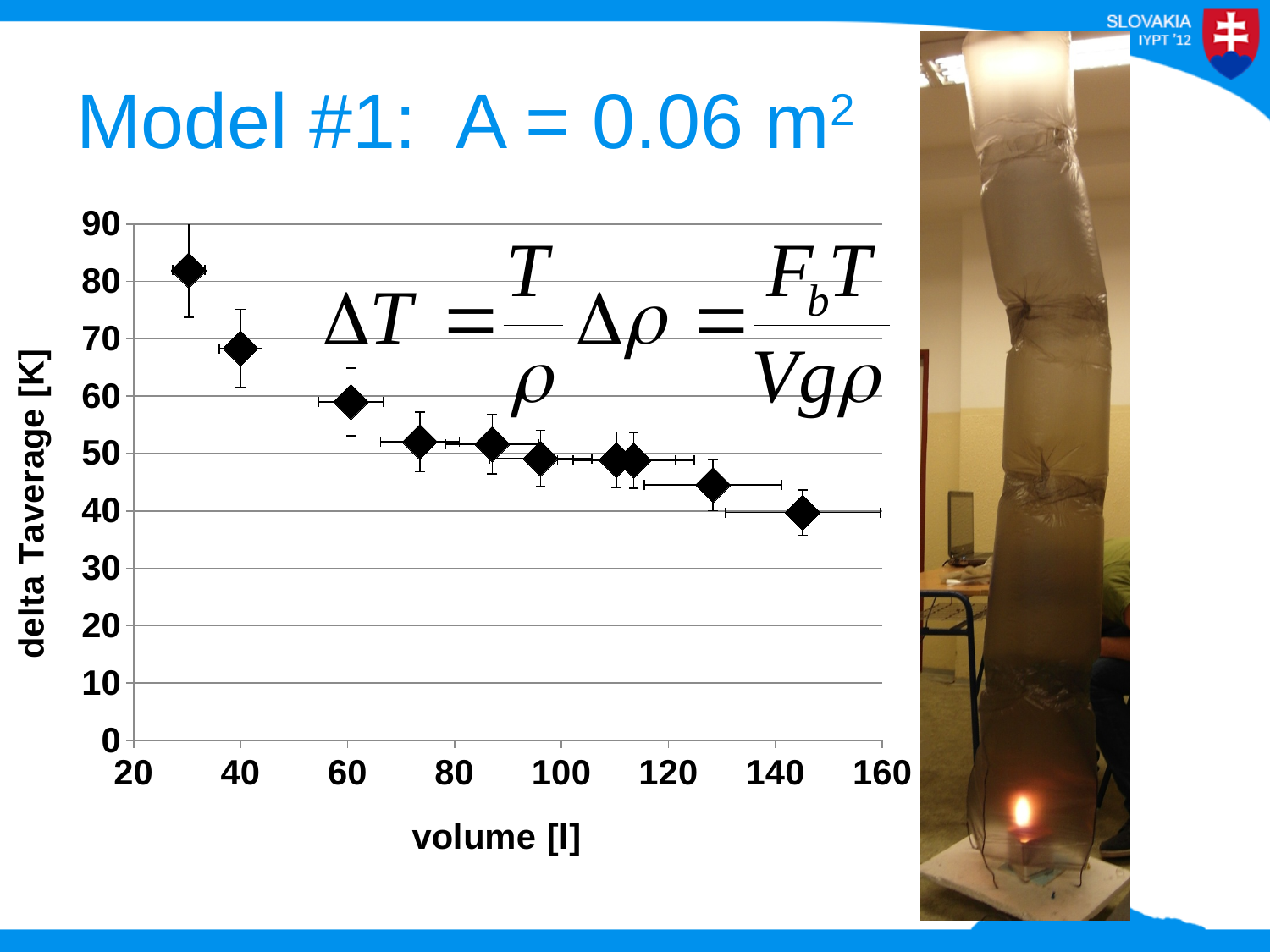
Is the delta Taverage value for the point at about 60 l volume greater or less than 50? greater Is the delta Taverage value for the point at about 145 l volume greater or less than 50? less What is the label of the x axis? volume [l] What is the label of the y axis? delta Taverage [K] Is the delta Taverage value for the point at about 40 l volume greater or less than 80? less What kind of chart is shown on the slide? scatter chart Do the plotted delta Taverage values rise or fall as volume increases along the x axis? fall Which has the larger delta Taverage: the point at about 30 l or the point at about 145 l? the point at about 30 l